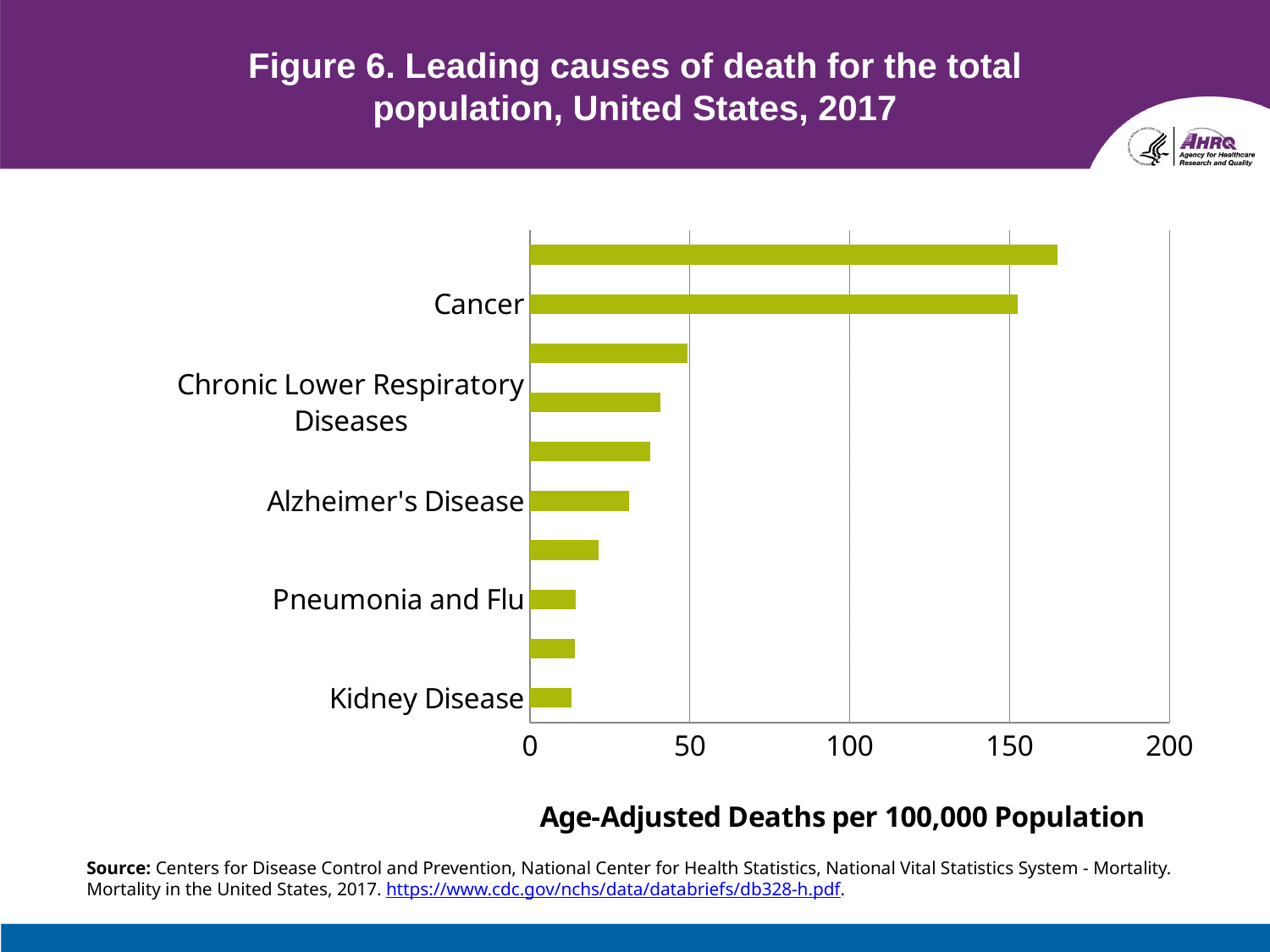
Is the value for Chronic Lower Respiratory Diseases greater or less than 50? less Which has a higher value, Chronic Lower Respiratory Diseases or Alzheimer's Disease? Chronic Lower Respiratory Diseases Is the value for Kidney Disease greater or less than 50? less How many bars are plotted in the chart? 10 Is the value for Pneumonia and Flu greater or less than 50? less What is the title of the horizontal axis? Age-Adjusted Deaths per 100,000 Population Which has a higher value, Cancer or Chronic Lower Respiratory Diseases? Cancer Do the bar values increase or decrease going from the top of the chart to the bottom? decrease Which has a higher value, Alzheimer's Disease or Pneumonia and Flu? Alzheimer's Disease What kind of chart is shown on the slide? bar chart